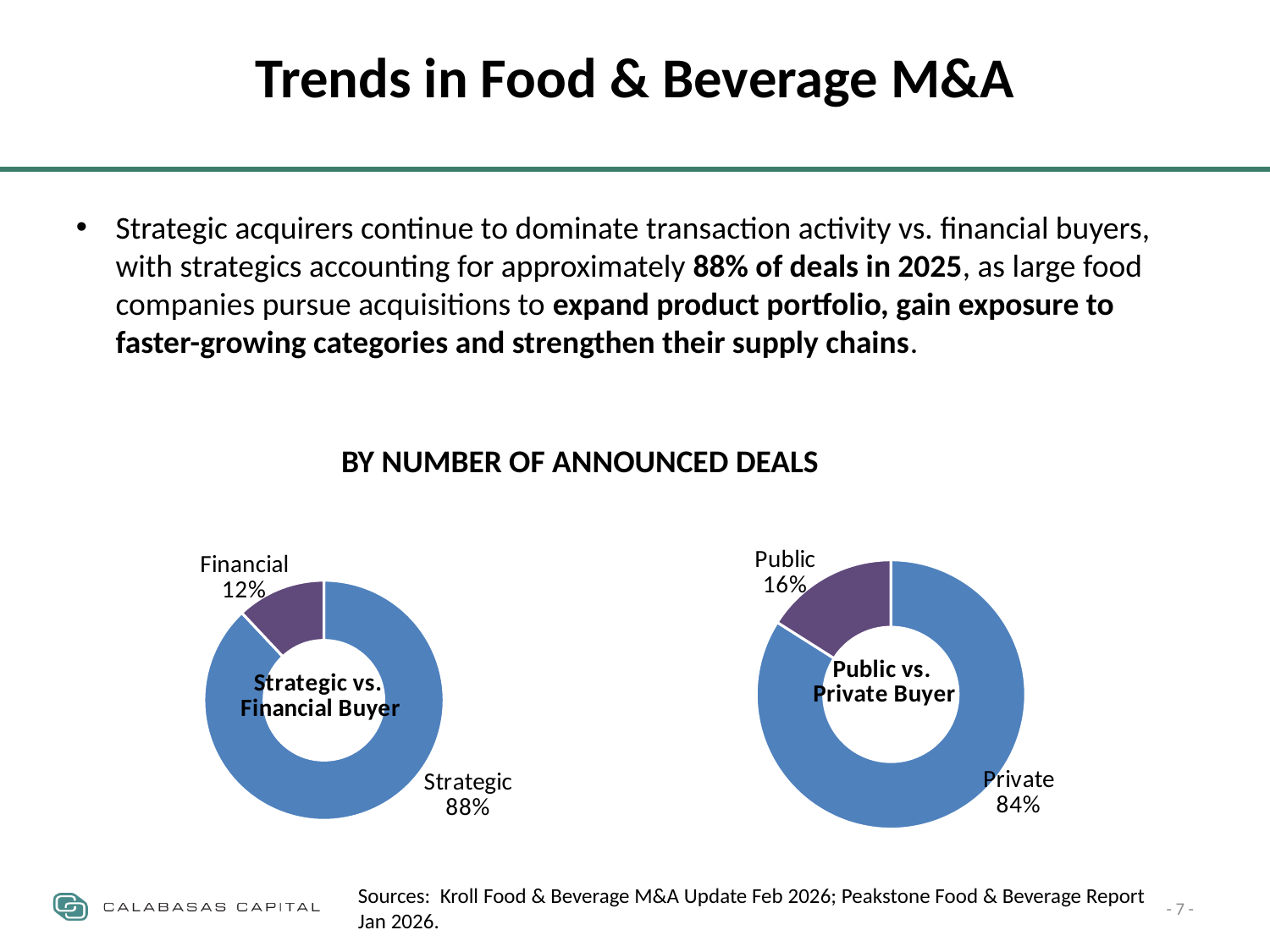
In the 'Public vs. Private Buyer' chart, what is the difference between the Private and Public shares? 68% In the 'Strategic vs. Financial Buyer' chart, what share of deals is Financial? 12% What is the heading shown above the two charts? BY NUMBER OF ANNOUNCED DEALS In the 'Public vs. Private Buyer' chart, what share of deals is Private? 84% In the 'Strategic vs. Financial Buyer' chart, which category has the largest share? Strategic What kind of chart is the 'Strategic vs. Financial Buyer' chart? Doughnut (pie) chart In the 'Strategic vs. Financial Buyer' chart, what is the difference between the Strategic and Financial shares? 76% Which is larger: the Financial share in the left chart or the Public share in the right chart? Public In the 'Public vs. Private Buyer' chart, which category has the smallest share? Public In the 'Public vs. Private Buyer' chart, what share of deals is Public? 16% How many categories does the 'Public vs. Private Buyer' chart show? 2 In the 'Strategic vs. Financial Buyer' chart, what share of deals is Strategic? 88%